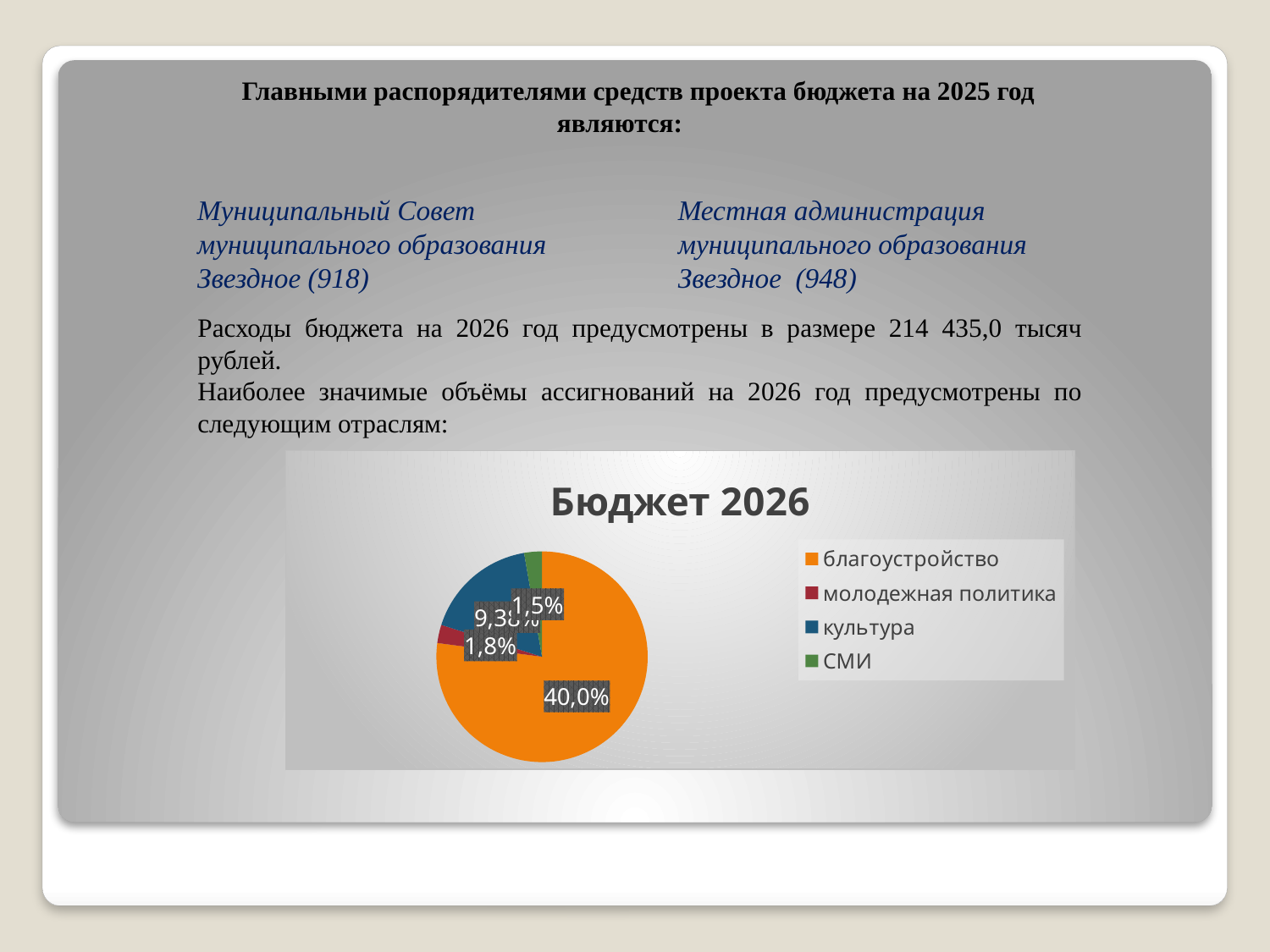
What share of the pie does СМИ have? 1,5% Which slice is larger, культура or молодежная политика? культура How many categories does the pie chart show? 4 What is the title of the chart? Бюджет 2026 Which category has the smallest slice of the pie? СМИ What share of the pie does молодежная политика have? 1,8% What is the difference between the shares of благоустройство and молодежная политика? 38,2% What kind of chart is shown on the slide? pie chart What share of the pie does благоустройство have? 40,0% What colour is the благоустройство slice? orange Which category has the largest slice of the pie? благоустройство How many entries does the legend list? 4